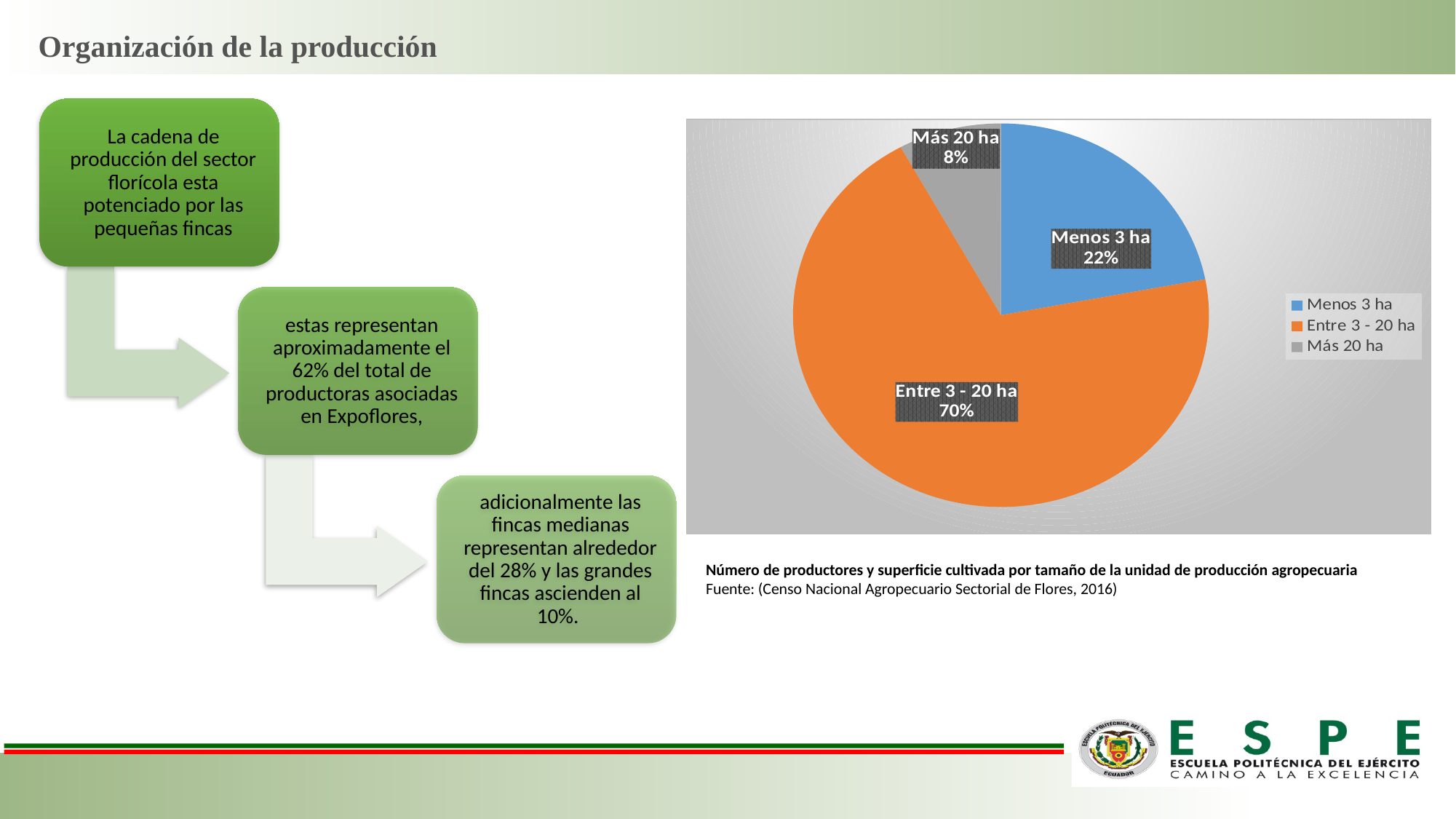
What colour is the slice for 'Entre 3 - 20 ha'? orange How many entries does the legend list? 3 Which category has the largest slice of the pie? Entre 3 - 20 ha Which category has the smallest slice of the pie? Más 20 ha What is the difference in percentage points between 'Entre 3 - 20 ha' and 'Menos 3 ha'? 48 What is the difference in percentage points between 'Menos 3 ha' and 'Más 20 ha'? 14 What kind of chart is shown on the slide? pie chart How many slices does the pie chart have? 3 What share of the pie does 'Entre 3 - 20 ha' represent? 70% What share of the pie does 'Menos 3 ha' represent? 22% Which is larger, the slice for 'Menos 3 ha' or the slice for 'Más 20 ha'? Menos 3 ha What share of the pie does 'Más 20 ha' represent? 8%